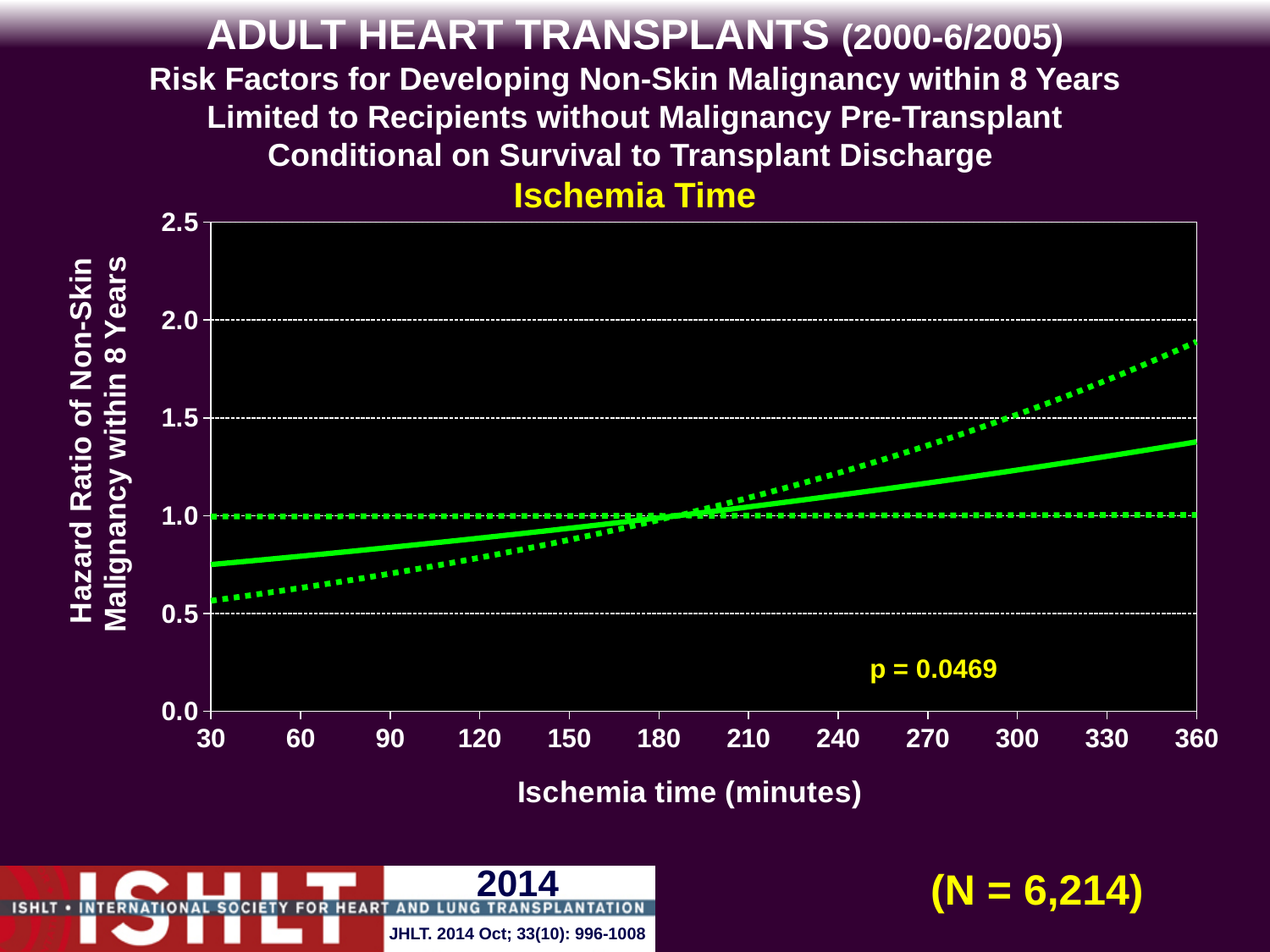
What p-value is printed on the chart? p = 0.0469 How many tick marks are labelled on the x axis (ischemia time)? 12 What kind of chart is shown on the slide? line chart Is the hazard ratio on the solid line at 30 minutes of ischemia time greater or less than 1.0? less Is the hazard ratio on the solid line larger at 30 minutes or at 360 minutes of ischemia time? 360 minutes Is the hazard ratio on the solid line at 30 minutes of ischemia time greater or less than 0.5? greater Does the solid hazard ratio line rise or fall as ischemia time increases from 30 to 360 minutes? rise What is the highest value labelled on the y axis? 2.5 Is the hazard ratio on the solid line at 360 minutes of ischemia time greater or less than 1.5? less